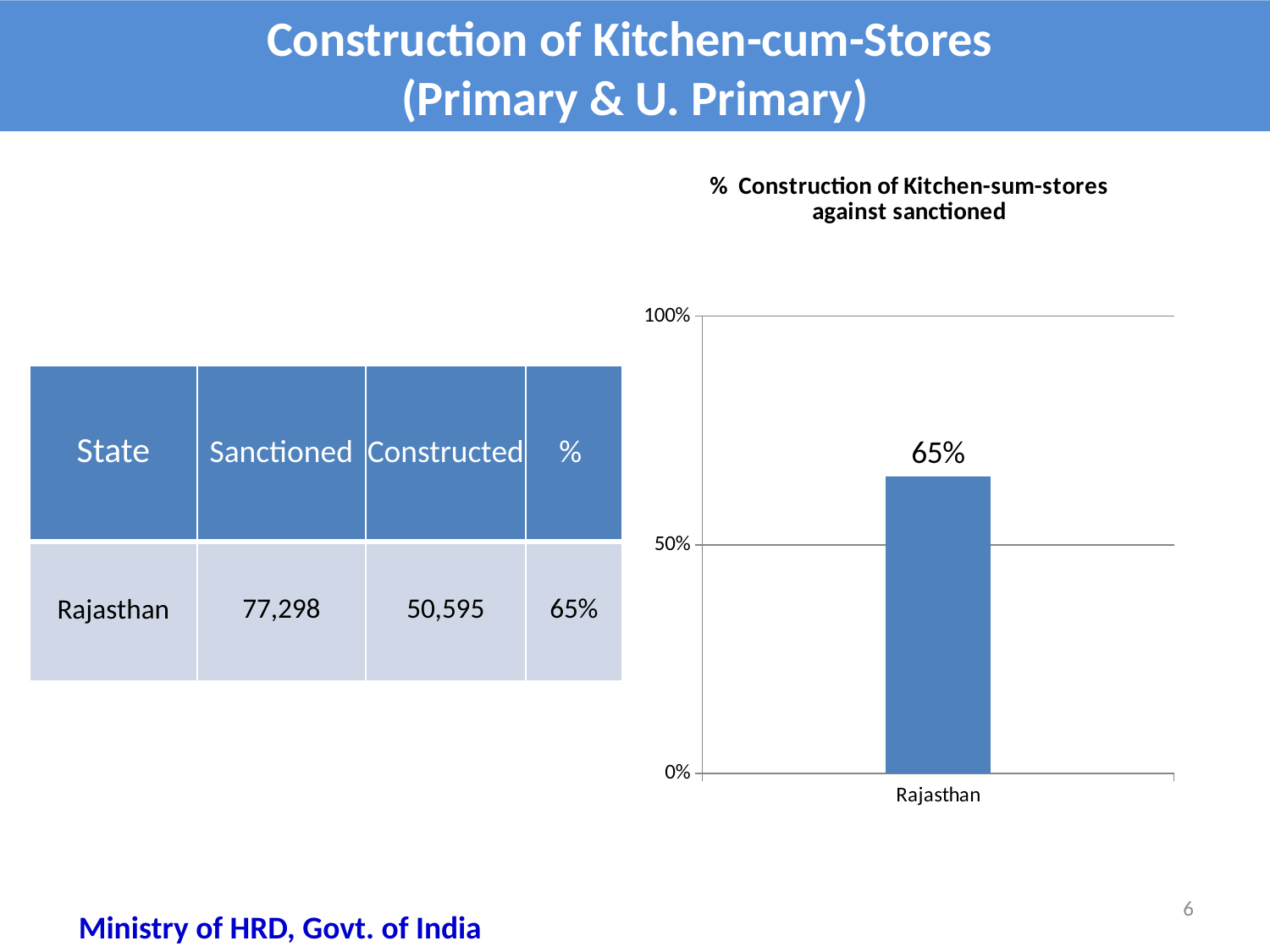
What kind of chart is shown on the slide? bar chart How many categories are plotted in the chart? 1 What is the highest value shown on the chart's y axis? 100% Which state is shown on the x axis of the chart? Rajasthan What is the value for Rajasthan in the chart? 65% Is the value for Rajasthan greater or less than 50%? greater Is the value for Rajasthan greater or less than 100%? less What is the title of the chart? % Construction of Kitchen-sum-stores against sanctioned